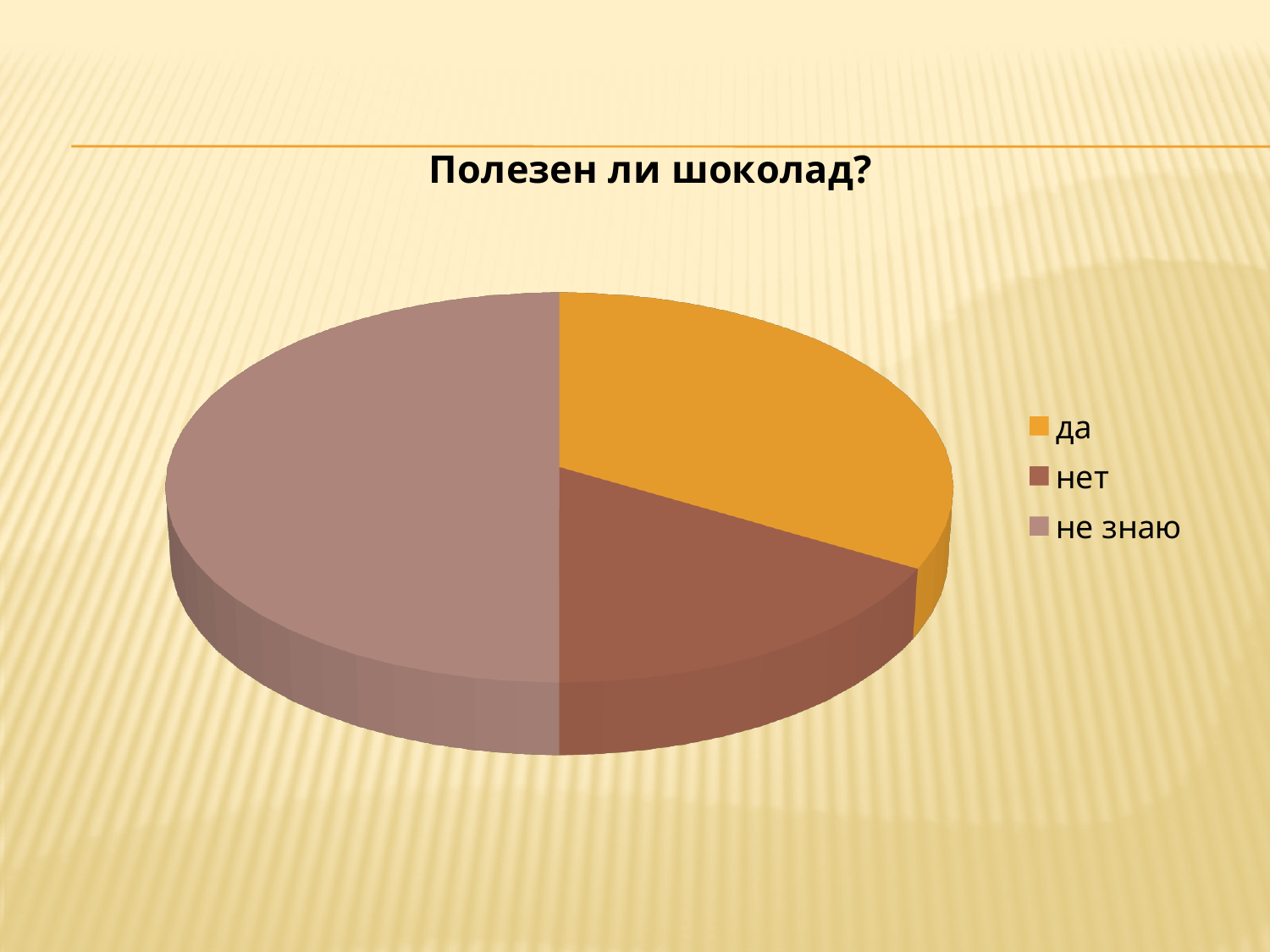
What is the title of the chart? Полезен ли шоколад? Which slice is larger, "не знаю" or "да"? не знаю How many entries does the legend list? 3 What kind of chart is shown on the slide? pie chart How many slices does the pie chart have? 3 Which answer option has the largest slice of the pie? не знаю Which slice is larger, "не знаю" or "нет"? не знаю Which legend entry is shown in orange? да